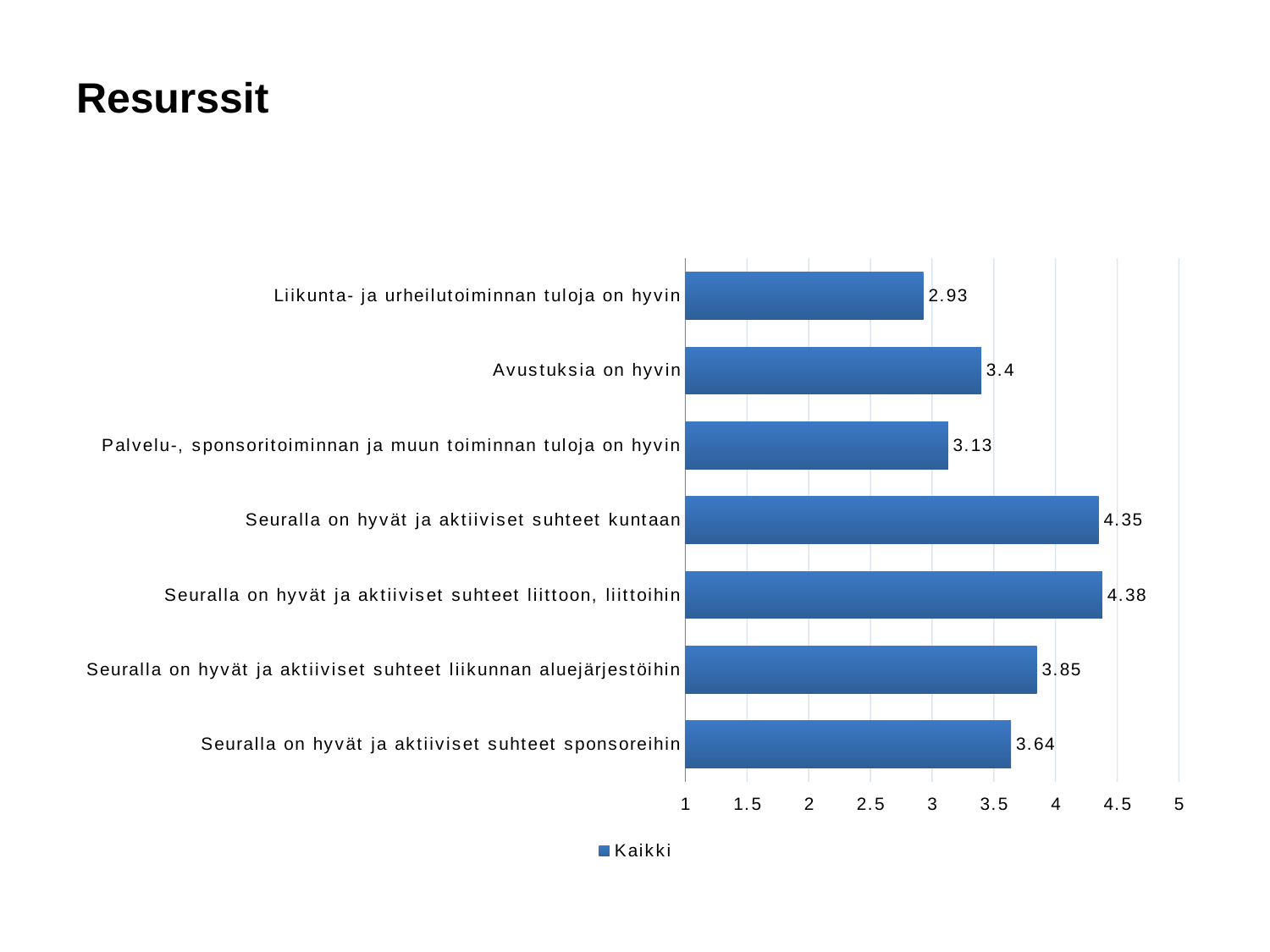
Is the value for "Liikunta- ja urheilutoiminnan tuloja on hyvin" greater or less than 3? less Which category has the highest value? Seuralla on hyvät ja aktiiviset suhteet liittoon, liittoihin What kind of chart is shown on the slide? Bar chart What is the value for "Seuralla on hyvät ja aktiiviset suhteet kuntaan"? 4.35 What is the difference between the values for "Seuralla on hyvät ja aktiiviset suhteet liikunnan aluejärjestöihin" and "Seuralla on hyvät ja aktiiviset suhteet sponsoreihin"? 0.21 What is the difference between the highest value and the lowest value in the chart? 1.45 What is the value for "Seuralla on hyvät ja aktiiviset suhteet sponsoreihin"? 3.64 Which category has the lowest value? Liikunta- ja urheilutoiminnan tuloja on hyvin What is the value for "Avustuksia on hyvin"? 3.4 How many series does the legend list? 1 Which is larger: the value for "Avustuksia on hyvin" or the value for "Palvelu-, sponsoritoiminnan ja muun toiminnan tuloja on hyvin"? Avustuksia on hyvin How many categories are shown in the chart? 7